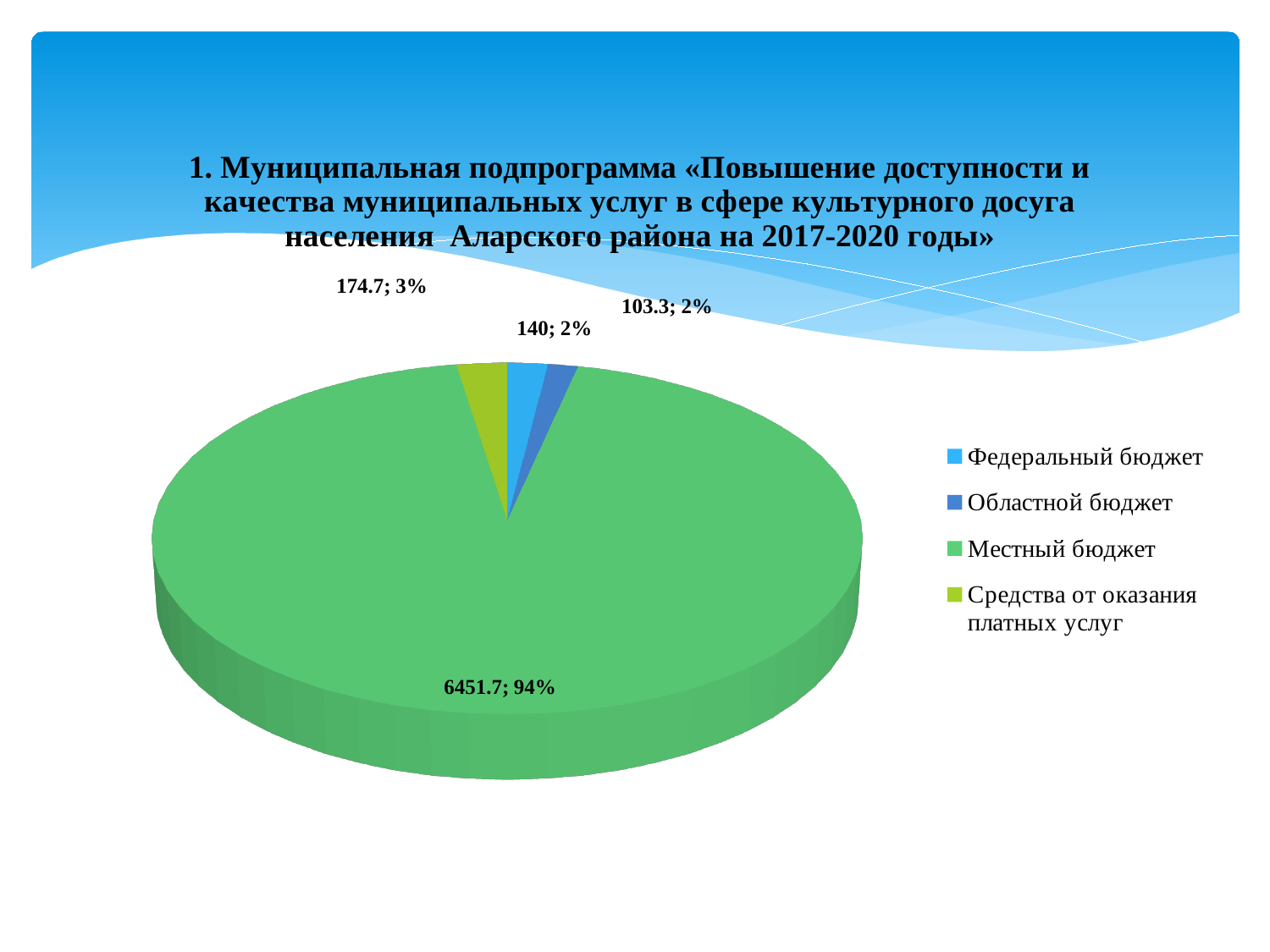
What is the value for Средства от оказания платных услуг? 174.7 What is the difference between the values for Средства от оказания платных услуг and Федеральный бюджет? 34.7 What kind of chart is shown on the slide? pie chart Which category has the smallest slice? Областной бюджет Which is larger, the value for Федеральный бюджет or the value for Областной бюджет? Федеральный бюджет How many categories does the legend list? 4 What share of the pie does Средства от оказания платных услуг represent? 3% What share of the pie does Местный бюджет represent? 94% What is the value for Областной бюджет? 103.3 What is the value for Местный бюджет? 6451.7 Which category has the largest slice? Местный бюджет What is the value for Федеральный бюджет? 140